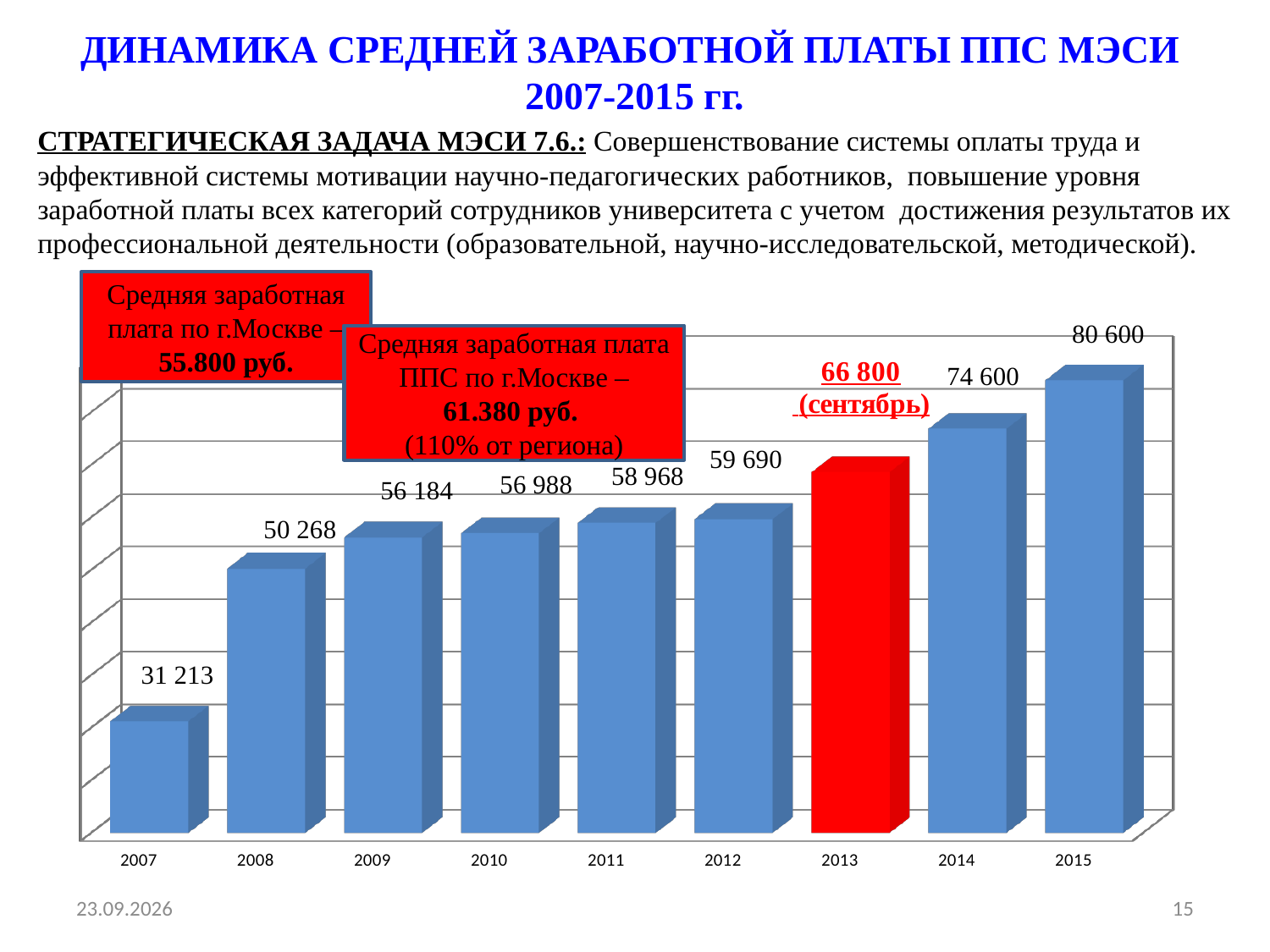
Which year has the highest value? 2015 What is the value shown for 2015? 80 600 What is the difference between the values for 2015 and 2014? 6 000 What is the value shown for 2007? 31 213 What is the value shown for 2013? 66 800 What is the difference between the values for 2008 and 2007? 19 055 What kind of chart is shown on the slide? bar chart Do the values rise or fall from 2007 to 2015? rise What is the value shown for 2010? 56 988 Which year has the lowest value? 2007 How many years are shown on the x axis? 9 Which is larger, the value for 2012 or the value for 2011? 2012